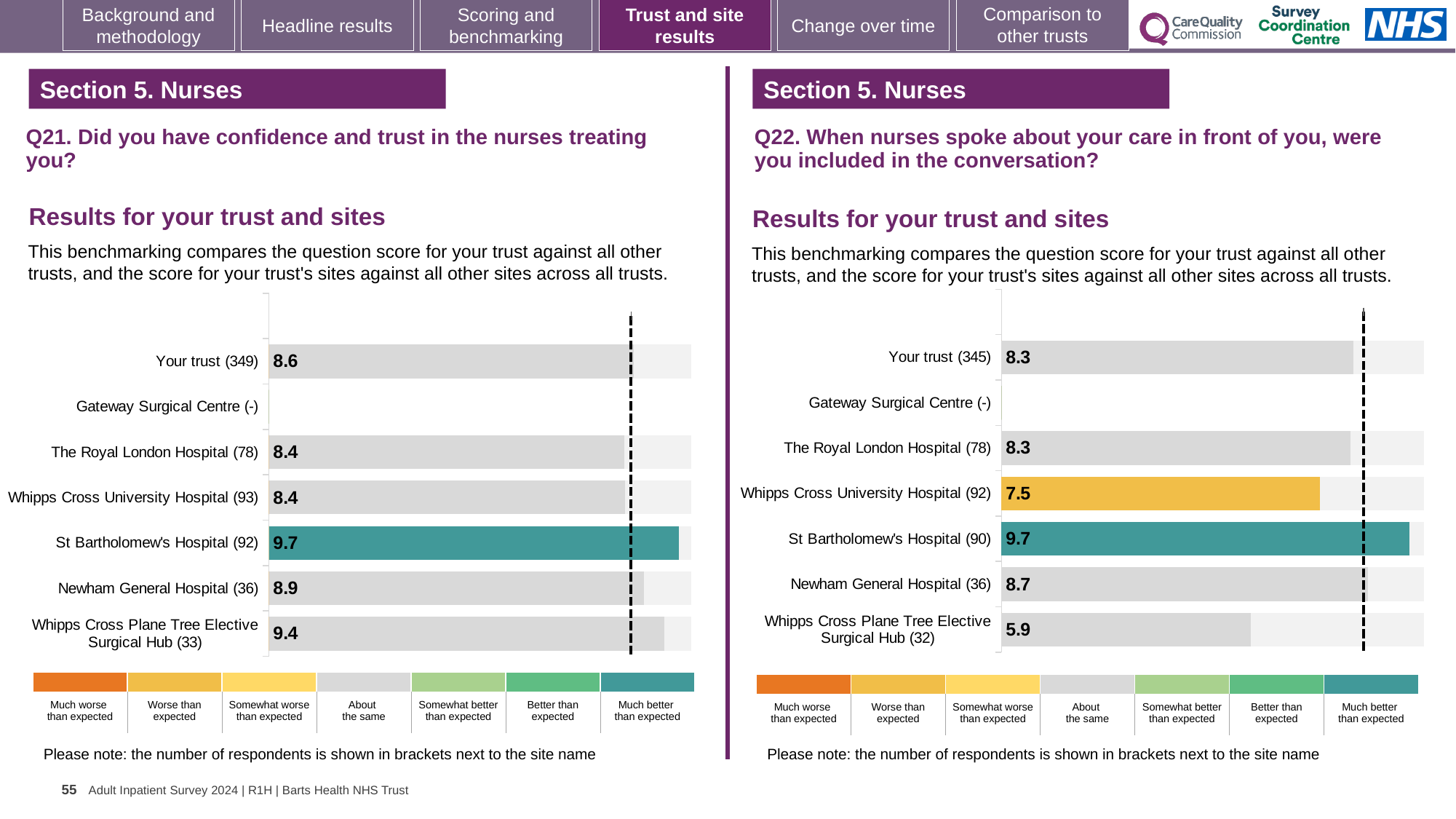
On the Q22 chart (right), what is the score for Whipps Cross University Hospital? 7.5 On the Q21 chart (left), what is the score for Your trust? 8.6 On the Q22 chart (right), which has the higher score, Newham General Hospital or Your trust? Newham General Hospital On the Q21 chart (left), how many sites or trust rows are listed on the vertical axis? 7 What kind of chart is used on the Q22 chart (right)? Bar chart On the Q21 chart (left), which has the higher score, Whipps Cross Plane Tree Elective Surgical Hub or The Royal London Hospital? Whipps Cross Plane Tree Elective Surgical Hub On the Q21 chart (left), what is the difference between the scores for St Bartholomew's Hospital and Newham General Hospital? 0.8 On the Q22 chart (right), what is the difference between the scores for St Bartholomew's Hospital and Whipps Cross Plane Tree Elective Surgical Hub? 3.8 On the Q22 chart (right), which site has the lowest score? Whipps Cross Plane Tree Elective Surgical Hub On the Q22 chart (right), which benchmark category does the colour of the Whipps Cross University Hospital bar represent? Worse than expected On the Q21 chart (left), which site has the highest score? St Bartholomew's Hospital On the Q21 chart (left), how many respondents are shown in brackets for St Bartholomew's Hospital? 92